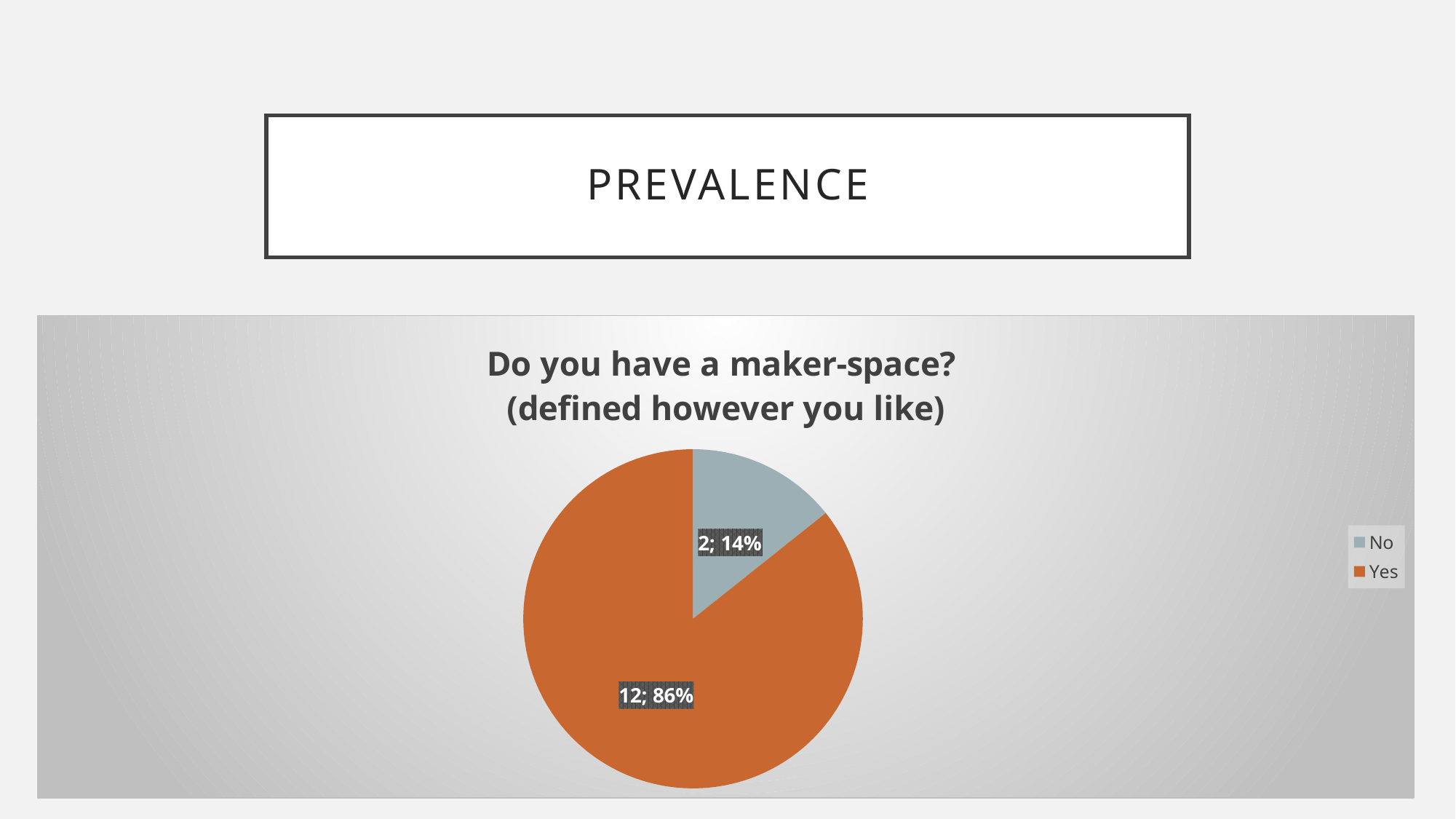
What kind of chart is shown on the slide? pie chart Which is larger, the "Yes" slice or the "No" slice? Yes What share of the pie does the "Yes" slice represent? 86% What is the difference between the number of "Yes" and "No" responses? 10 What share of the pie does the "No" slice represent? 14% How many respondents answered "No"? 2 What colour is the "Yes" slice? orange How many categories does the pie chart have? 2 Which category has the largest slice? Yes Which category has the smallest slice? No How many respondents answered "Yes"? 12 What is the title of the chart? Do you have a maker-space? (defined however you like)